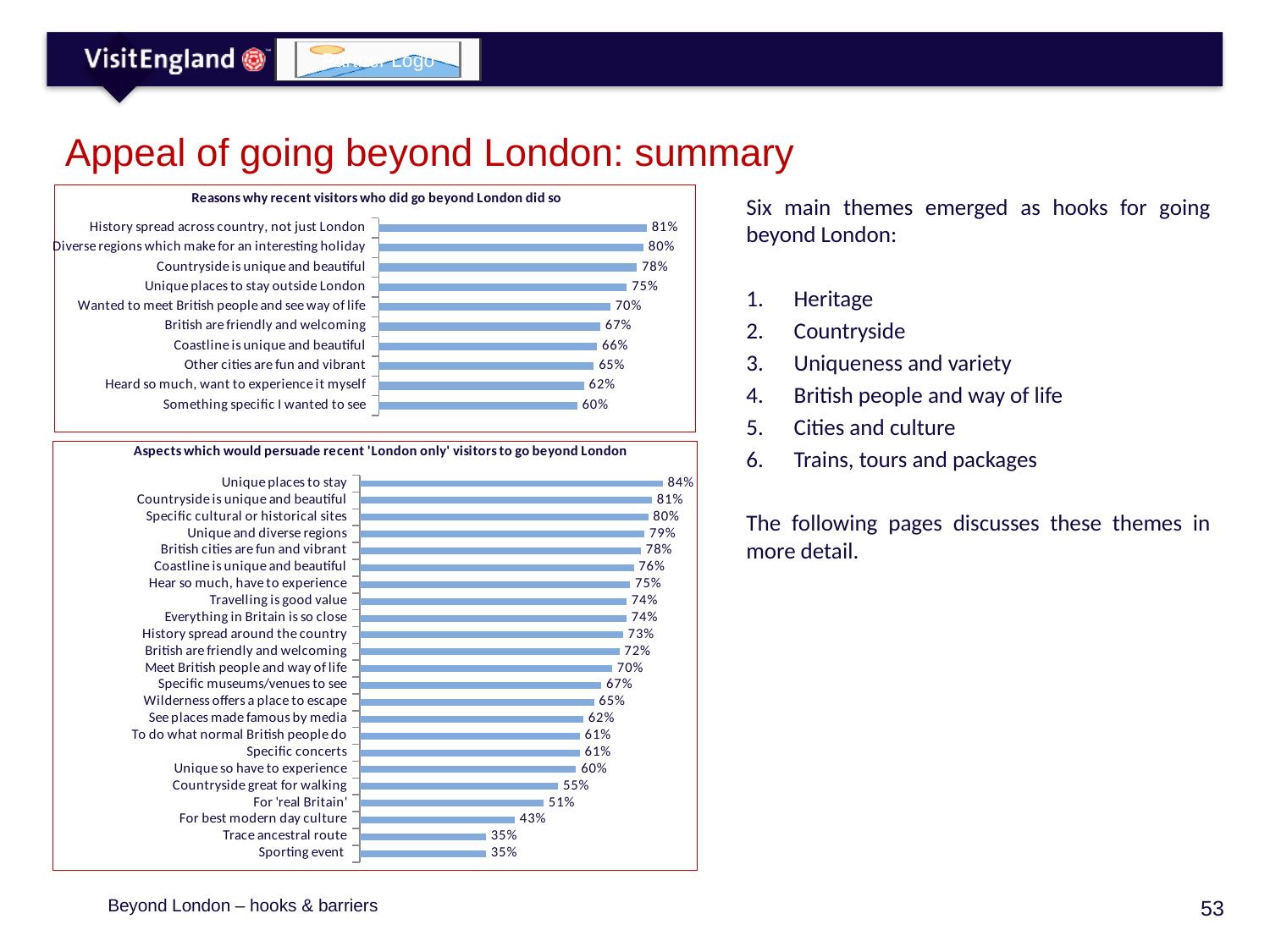
In the chart 'Aspects which would persuade recent 'London only' visitors to go beyond London', what is the value for 'Countryside great for walking'? 55% In the chart 'Aspects which would persuade recent 'London only' visitors to go beyond London', which is larger: 'Specific museums/venues to see' or 'Wilderness offers a place to escape'? Specific museums/venues to see In the chart 'Reasons why recent visitors who did go beyond London did so', which reason has the highest value? History spread across country, not just London How many aspects are listed in the chart 'Aspects which would persuade recent 'London only' visitors to go beyond London'? 23 In the chart 'Reasons why recent visitors who did go beyond London did so', what is the difference between 'History spread across country, not just London' and 'Something specific I wanted to see'? 21 percentage points What type of chart is the top chart on the slide? Bar chart In the chart 'Aspects which would persuade recent 'London only' visitors to go beyond London', which aspect has the highest value? Unique places to stay How many reasons are listed in the chart 'Reasons why recent visitors who did go beyond London did so'? 10 In the chart 'Reasons why recent visitors who did go beyond London did so', what is the value for 'Countryside is unique and beautiful'? 78% In the chart 'Aspects which would persuade recent 'London only' visitors to go beyond London', what is the value for 'For best modern day culture'? 43% In the chart 'Aspects which would persuade recent 'London only' visitors to go beyond London', what is the difference between 'Unique places to stay' and 'Sporting event'? 49 percentage points In the chart 'Reasons why recent visitors who did go beyond London did so', which reason has the lowest value? Something specific I wanted to see